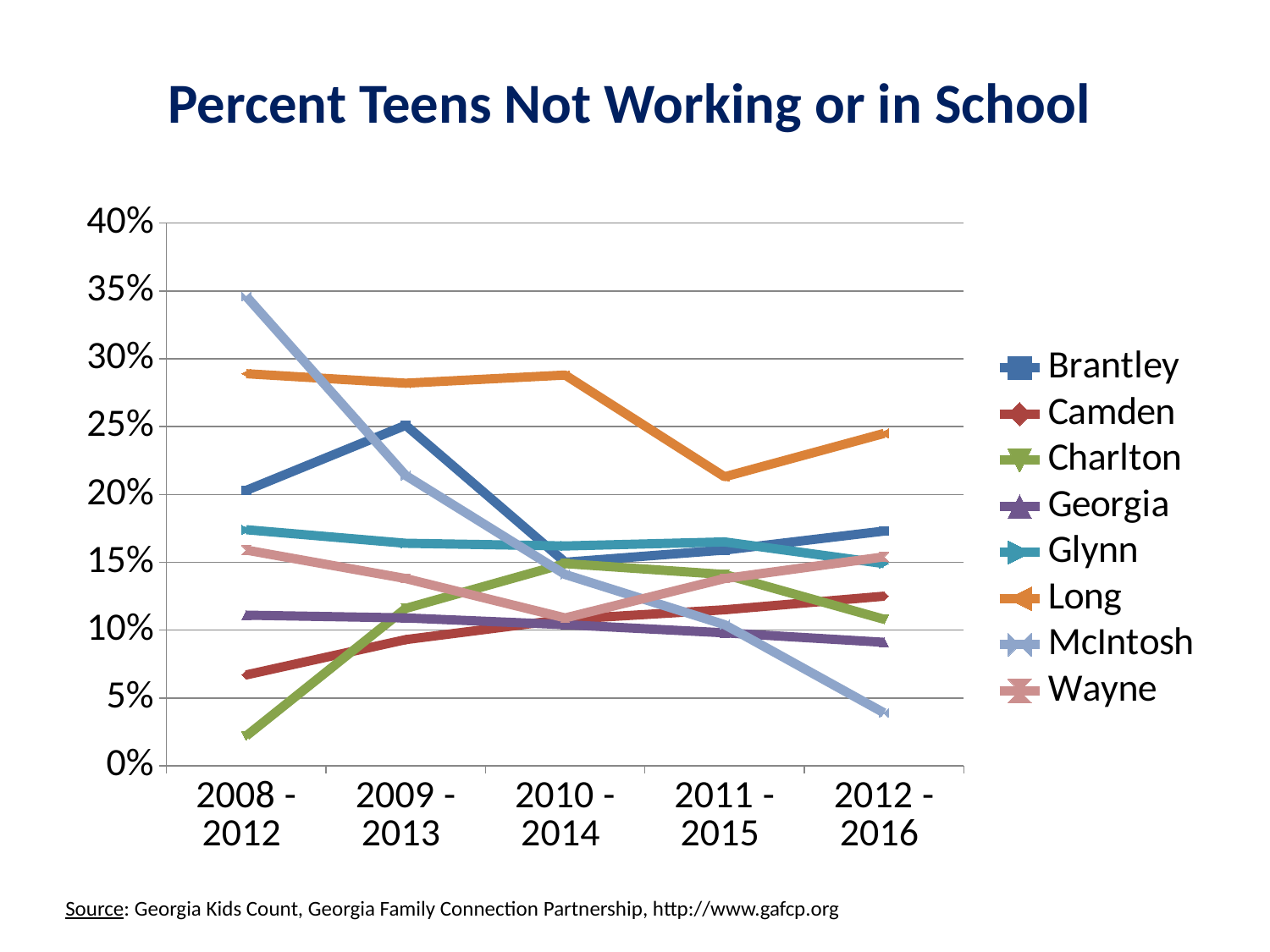
What kind of chart is shown on the slide? line chart Which series has the lowest value in 2008 - 2012? Charlton Which is larger in 2009 - 2013, Long or Brantley? Long Is the value for Long in 2011 - 2015 greater or less than 25%? less Does the McIntosh line rise or fall from 2008 - 2012 to 2012 - 2016? fall Which series has the highest value in 2012 - 2016? Long Which series has the highest value in 2008 - 2012? McIntosh Is the value for McIntosh in 2008 - 2012 greater or less than 30%? greater Which series has the lowest value in 2012 - 2016? McIntosh What is the title of the chart? Percent Teens Not Working or in School How many time periods are shown on the x axis? 5 How many series does the legend list? 8